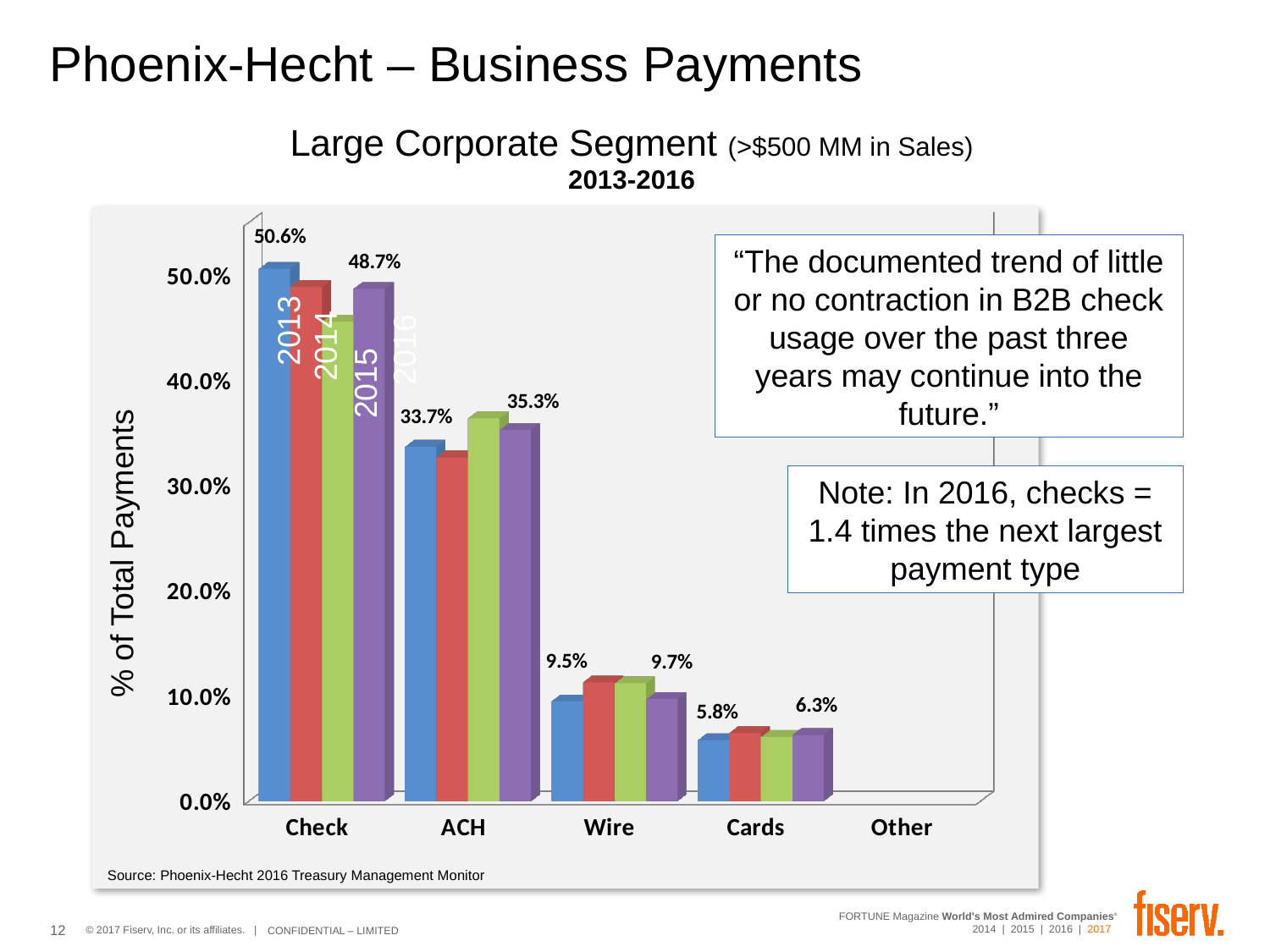
Which payment type has the highest share of total payments? Check What is the 2016 value for Cards? 6.3% What is the difference between the 2013 and 2016 values for Check? 1.9% How many series does the chart show? 4 Is the 2014 value for Check greater or less than 40.0%? greater What is the difference between the 2016 and 2013 values for ACH? 1.6% What is the 2016 value for ACH? 35.3% Which is larger, the 2013 value for ACH or the 2016 value for ACH? 2016 What is the 2016 value for Check? 48.7% What kind of chart is shown on the slide? Bar chart What is the 2013 value for Check? 50.6% What is the 2013 value for Wire? 9.5%